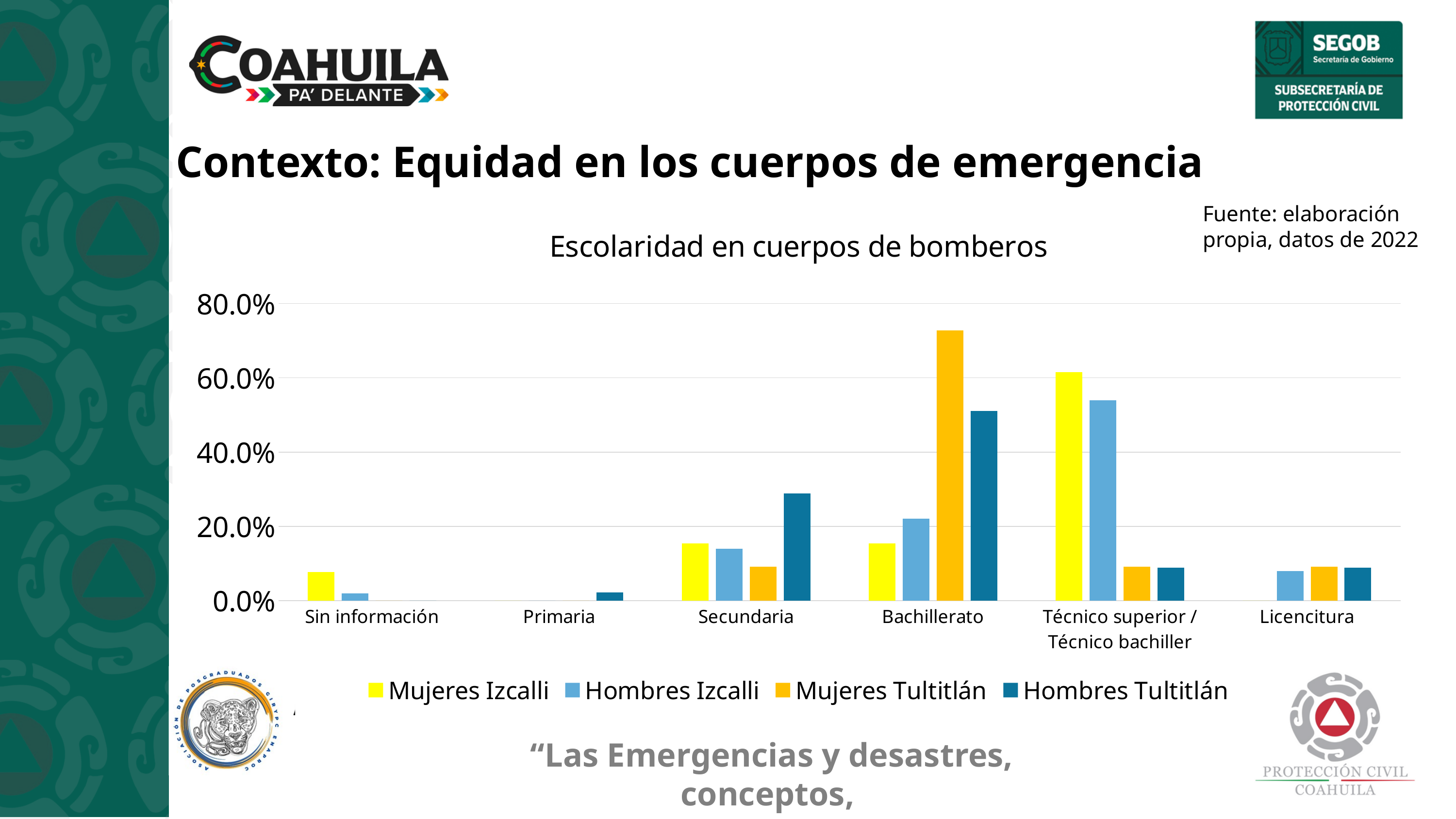
In Bachillerato, which is larger: Mujeres Tultitlán or Hombres Tultitlán? Mujeres Tultitlán For which category is the Mujeres Izcalli bar the highest? Técnico superior / Técnico bachiller Is the value for Hombres Izcalli in Técnico superior / Técnico bachiller greater or less than 40.0%? greater Is the value for Hombres Tultitlán in Secundaria greater or less than 40.0%? less For which category is the Mujeres Tultitlán bar the highest? Bachillerato For which category is the Hombres Tultitlán bar the highest? Bachillerato Is the value for Mujeres Tultitlán in Bachillerato greater or less than 60.0%? greater How many series does the legend of the chart list? 4 What is the title of the chart? Escolaridad en cuerpos de bomberos How many education-level categories are shown on the x axis of the chart? 6 What kind of chart is shown on the slide? Bar chart